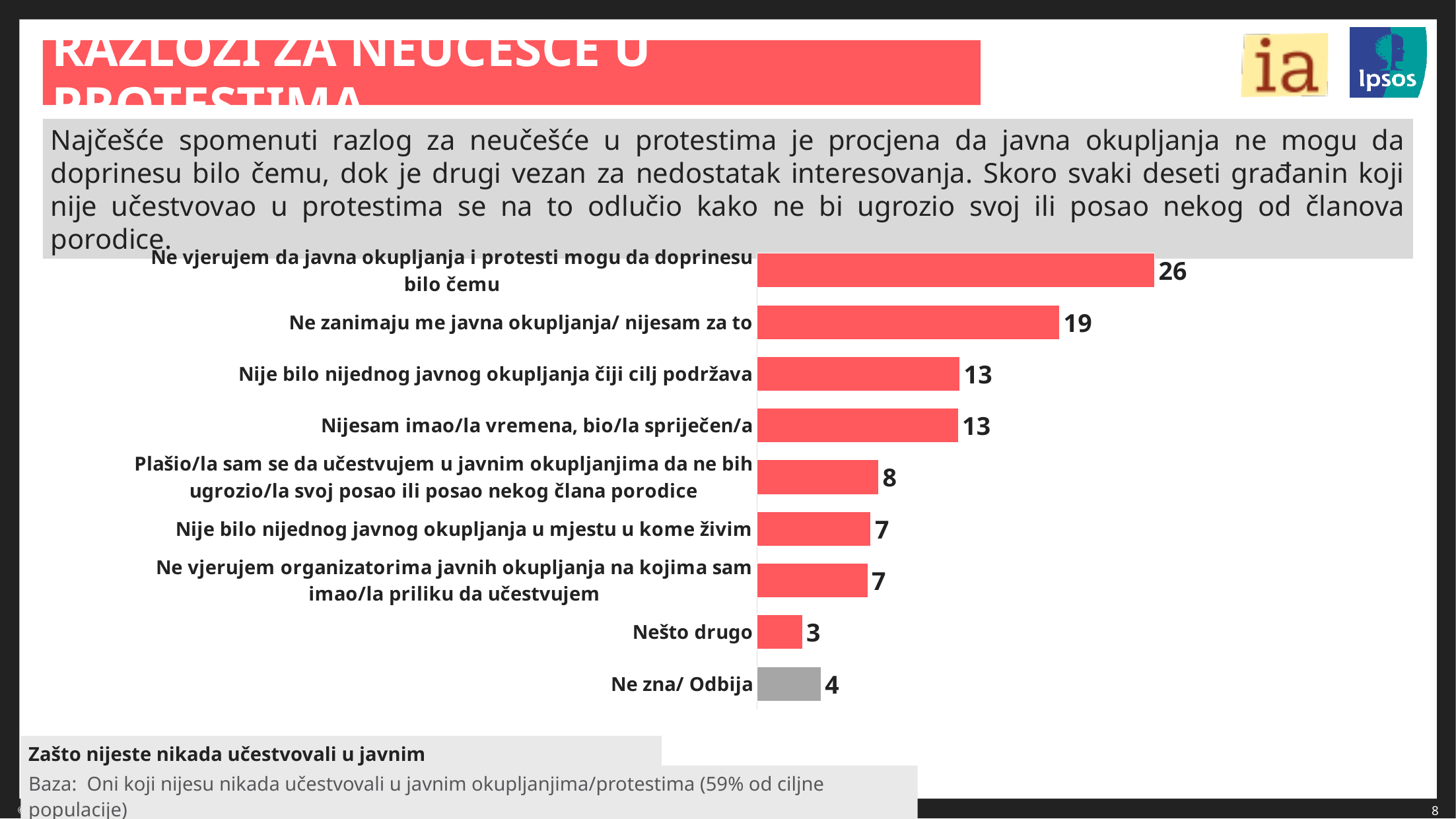
What value is shown for "Ne zna/ Odbija"? 4 What value is shown for "Nije bilo nijednog javnog okupljanja u mjestu u kome živim"? 7 What is the difference between the values for "Ne vjerujem da javna okupljanja i protesti mogu da doprinesu bilo čemu" and "Ne zanimaju me javna okupljanja/ nijesam za to"? 7 What value is shown for "Nešto drugo"? 3 Which is larger: the value for "Ne zna/ Odbija" or the value for "Nešto drugo"? Ne zna/ Odbija Which bar is coloured grey rather than red? Ne zna/ Odbija Which category has the highest value? Ne vjerujem da javna okupljanja i protesti mogu da doprinesu bilo čemu What value is shown for "Ne zanimaju me javna okupljanja/ nijesam za to"? 19 What is the difference between the values for "Nijesam imao/la vremena, bio/la spriječen/a" and "Plašio/la sam se da učestvujem u javnim okupljanjima da ne bih ugrozio/la svoj posao ili posao nekog člana porodice"? 5 What kind of chart is shown on the slide? Bar chart How many categories are shown in the chart? 9 Which category has the lowest value? Nešto drugo